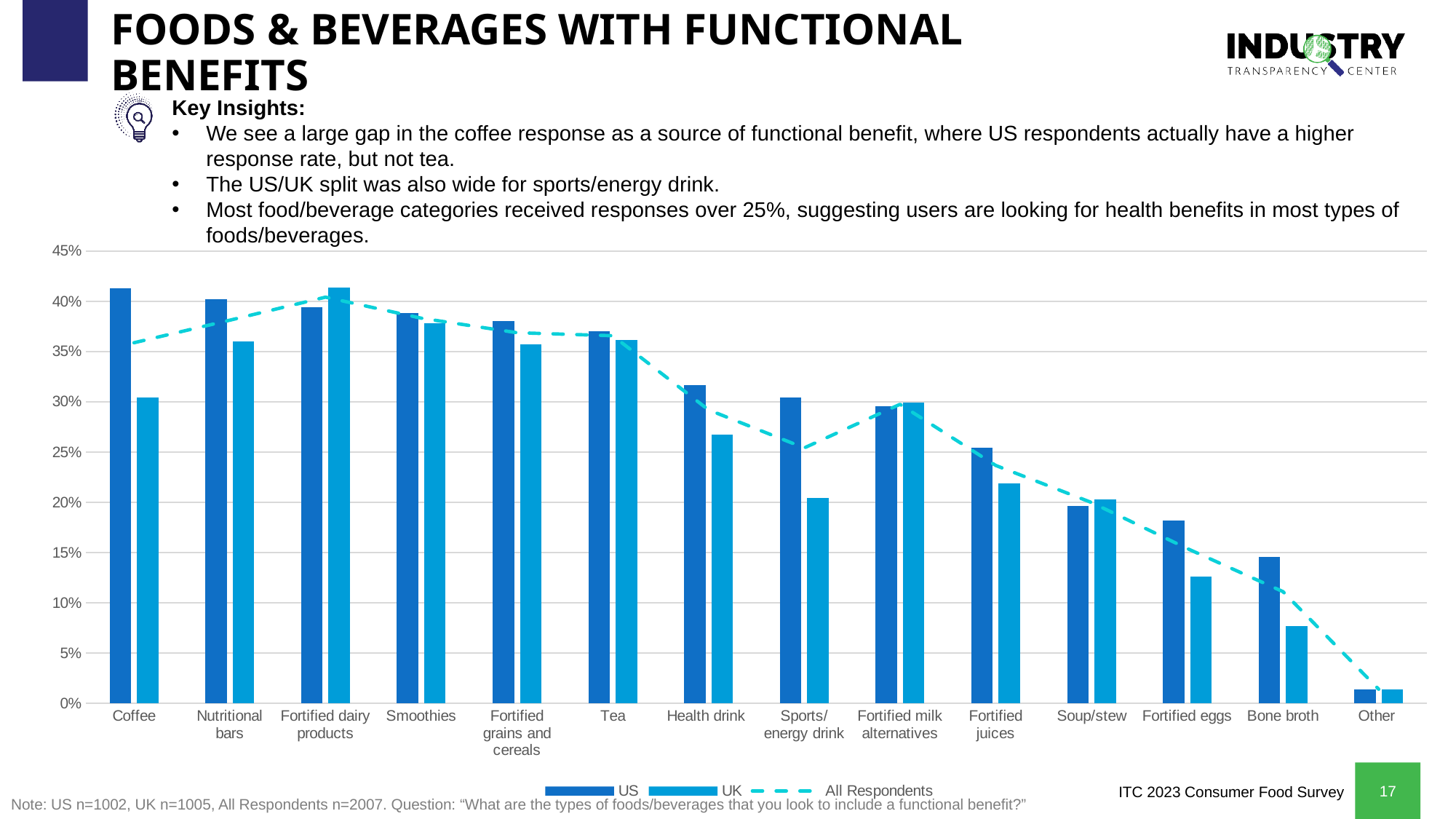
Is the US value for Coffee greater or less than 40%? greater Is the UK value for Bone broth greater or less than 10%? less Which category has the lowest US value? Other Which series is drawn as a dashed line rather than bars? All Respondents How many food/beverage categories are shown on the x axis? 14 For Fortified dairy products, which is larger, the US value or the UK value? UK Is the UK value for Sports/energy drink greater or less than 25%? less Which category has the highest US value? Coffee For Coffee, which is larger, the US value or the UK value? US What kind of chart is shown on the slide? combination bar and line chart Which category has the highest UK value? Fortified dairy products How many series does the legend list? 3